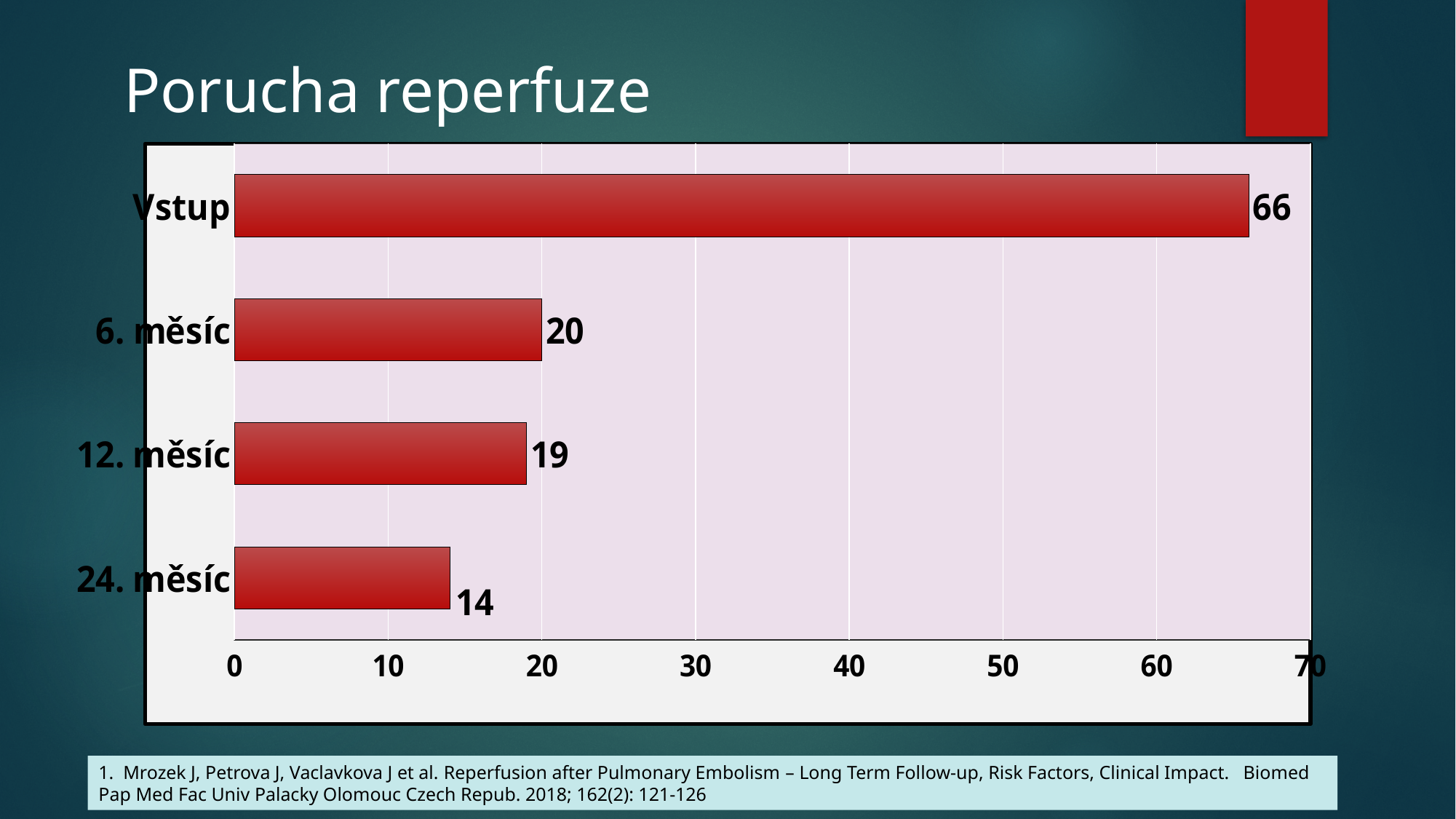
What is the title of the slide containing the chart? Porucha reperfuze Which is larger, the value for Vstup or the value for 6. měsíc? Vstup What is the difference between the values for 6. měsíc and 12. měsíc? 1 What is the value for 6. měsíc? 20 Which category has the highest value? Vstup What is the difference between the values for Vstup and 24. měsíc? 52 What is the value for Vstup? 66 What is the value for 24. měsíc? 14 How many categories are shown in the chart? 4 Which category has the lowest value? 24. měsíc What is the value for 12. měsíc? 19 What kind of chart is shown on the slide? Bar chart